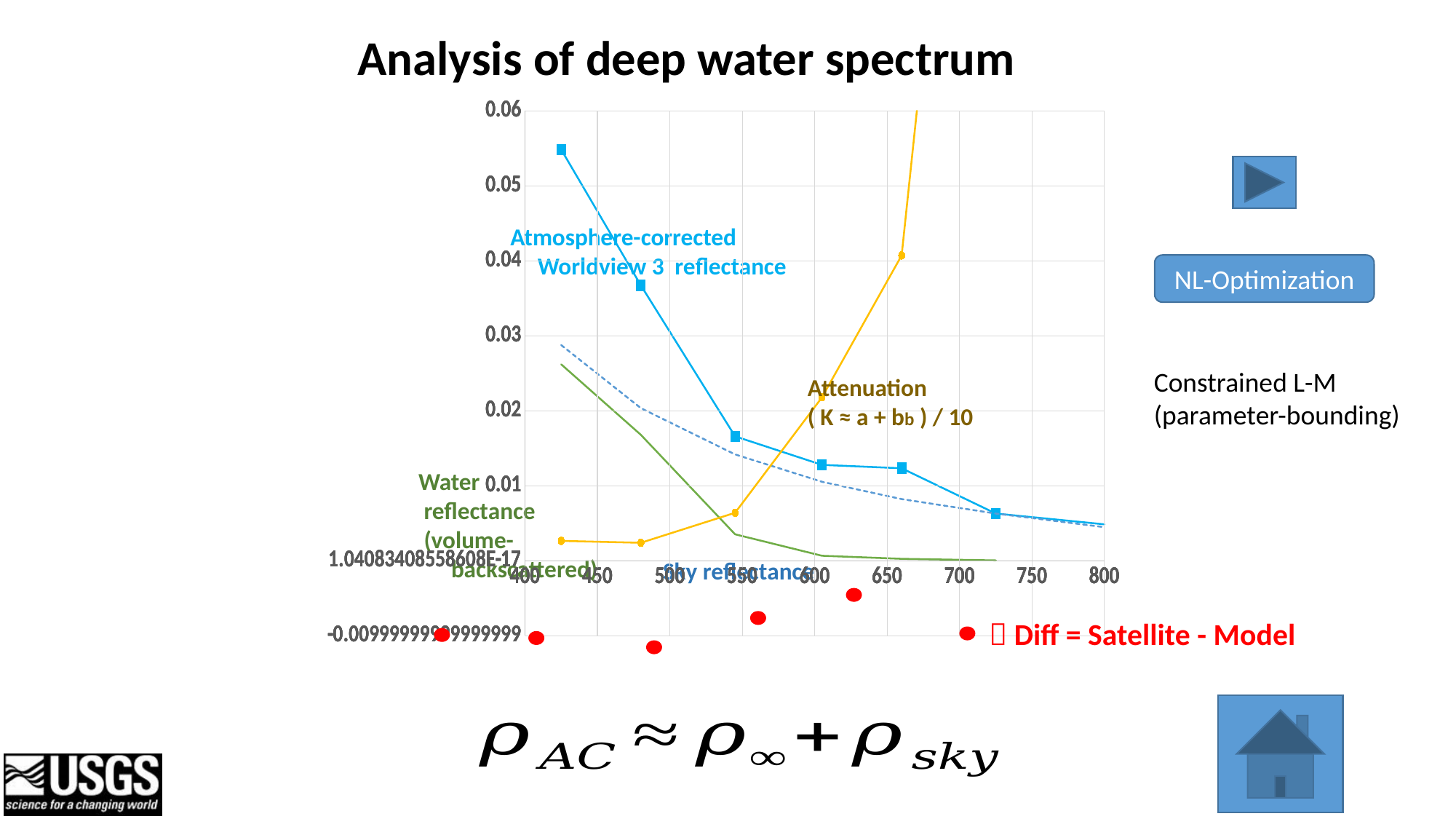
What is the title of the slide containing the chart? Analysis of deep water spectrum Is the first (leftmost) Atmosphere-corrected Worldview 3 reflectance value greater or less than 0.05? greater Does the Water reflectance series rise or fall as wavelength increases along the x axis? fall At the leftmost point of the chart, which is larger: the Atmosphere-corrected Worldview 3 reflectance or the Water reflectance? Atmosphere-corrected Worldview 3 reflectance Does the Atmosphere-corrected Worldview 3 reflectance series rise or fall as wavelength increases along the x axis? fall Is the leftmost Water reflectance value greater or less than 0.02? greater Is the Attenuation value at about 550 nm greater or less than 0.01? less Does the Attenuation series rise or fall as wavelength increases along the x axis? rise How many square markers are plotted for the Atmosphere-corrected Worldview 3 reflectance series? 6 What kind of chart is shown on the slide? line chart What colour is the Attenuation series drawn in? yellow